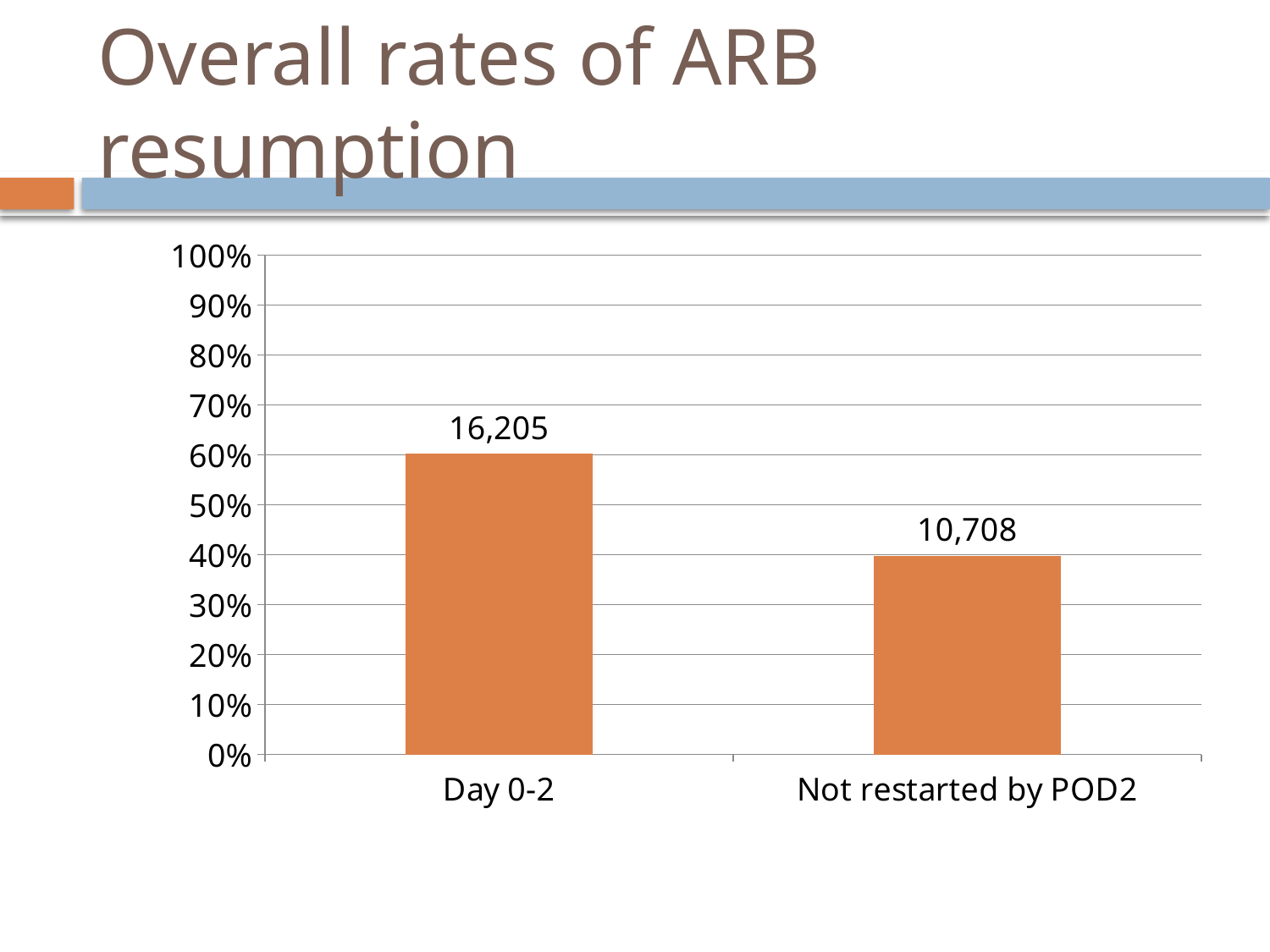
Is the bar for Day 0-2 greater or less than 50% on the vertical axis? greater What is the data label shown on the bar for Day 0-2? 16,205 What is the data label shown on the bar for Not restarted by POD2? 10,708 Is the bar for Not restarted by POD2 greater or less than 30% on the vertical axis? greater Which category has the taller bar? Day 0-2 What is the difference between the data labels for Day 0-2 and Not restarted by POD2? 5,497 What kind of chart is shown on the slide? bar chart How many categories are shown on the x axis of the chart? 2 What is the title of the slide containing the chart? Overall rates of ARB resumption Is the data label for Day 0-2 larger or smaller than the data label for Not restarted by POD2? larger Which category has the shorter bar? Not restarted by POD2 Is the bar for Not restarted by POD2 greater or less than 50% on the vertical axis? less